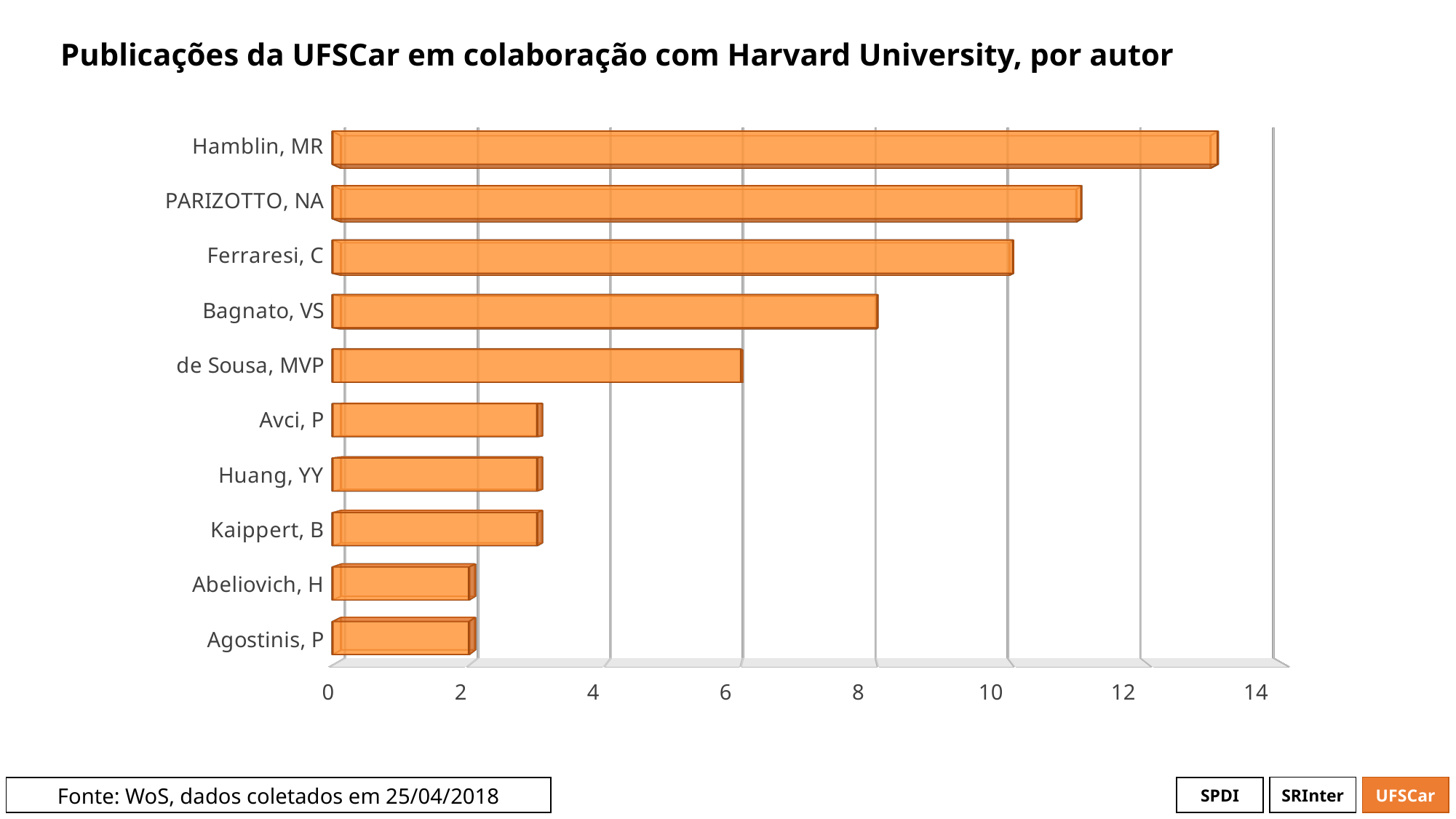
Which has more publications, Ferraresi, C or Bagnato, VS? Ferraresi, C Is the value for Bagnato, VS greater or less than 10? less Is the value for Hamblin, MR greater or less than 12? greater Which author has the highest number of publications? Hamblin, MR Is the value for Avci, P greater or less than 4? less Which has more publications, de Sousa, MVP or Kaippert, B? de Sousa, MVP What is the title of the chart? Publicações da UFSCar em colaboração com Harvard University, por autor How many authors are shown in the chart? 10 What kind of chart is shown on the slide? bar chart